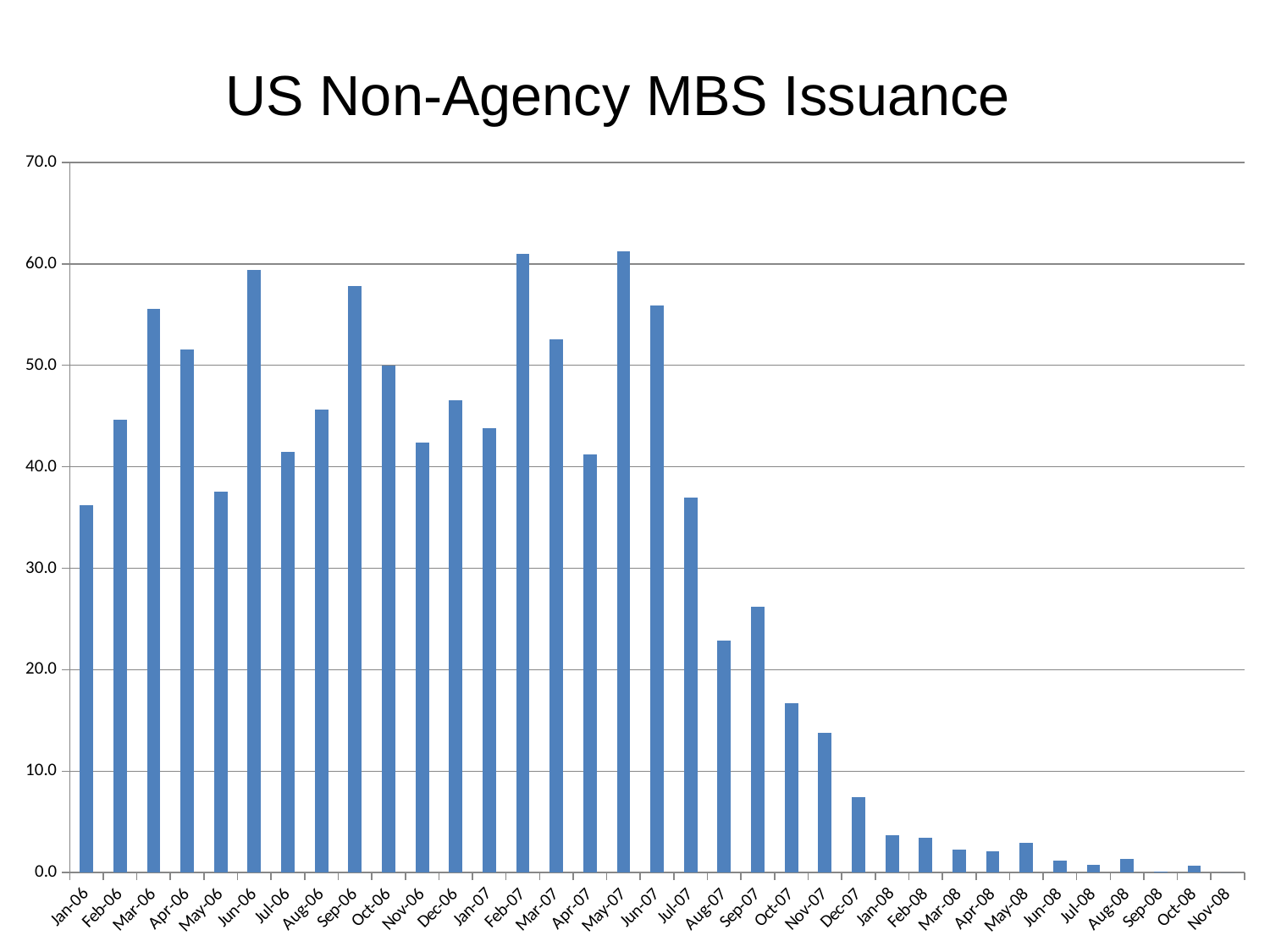
Is the value for Jun-06 greater or less than 50.0? greater What kind of chart is shown on the slide? Bar chart Is the value for Jul-07 greater or less than 40.0? less Which is larger, the value for Nov-07 or the value for Dec-07? Nov-07 Is the value for Dec-07 greater or less than 10.0? less How many months are plotted along the x axis? 35 What is the title of the chart? US Non-Agency MBS Issuance Which is larger, the value for Mar-06 or the value for May-06? Mar-06 Which is larger, the value for Jun-07 or the value for Jul-07? Jun-07 Do the values generally rise or fall from Jun-07 to Nov-08? fall